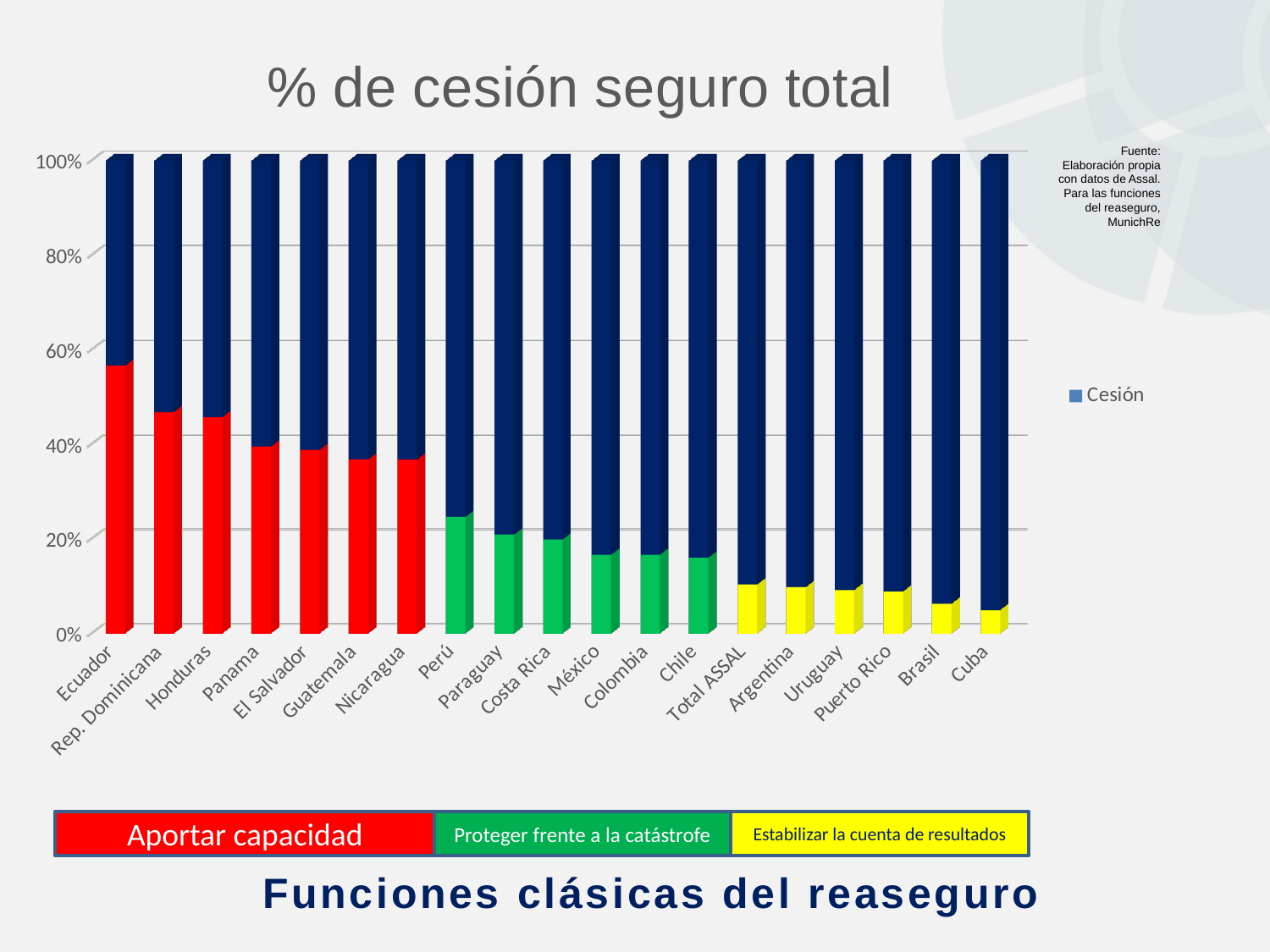
Is the cesión value for Perú greater or less than 40%? less Do the cesión values rise or fall moving from left to right along the x axis? fall What is the name of the series shown in the legend? Cesión How many countries or categories are shown on the x axis? 19 What kind of chart is shown on the slide? bar chart What is the title of the chart? % de cesión seguro total Is the cesión value for Ecuador greater or less than 40%? greater How many series does the legend list? 1 Is the cesión value for Cuba greater or less than 20%? less Which has a larger cesión value, Ecuador or Perú? Ecuador Which category has the lowest cesión value? Cuba Which category has the highest cesión value? Ecuador